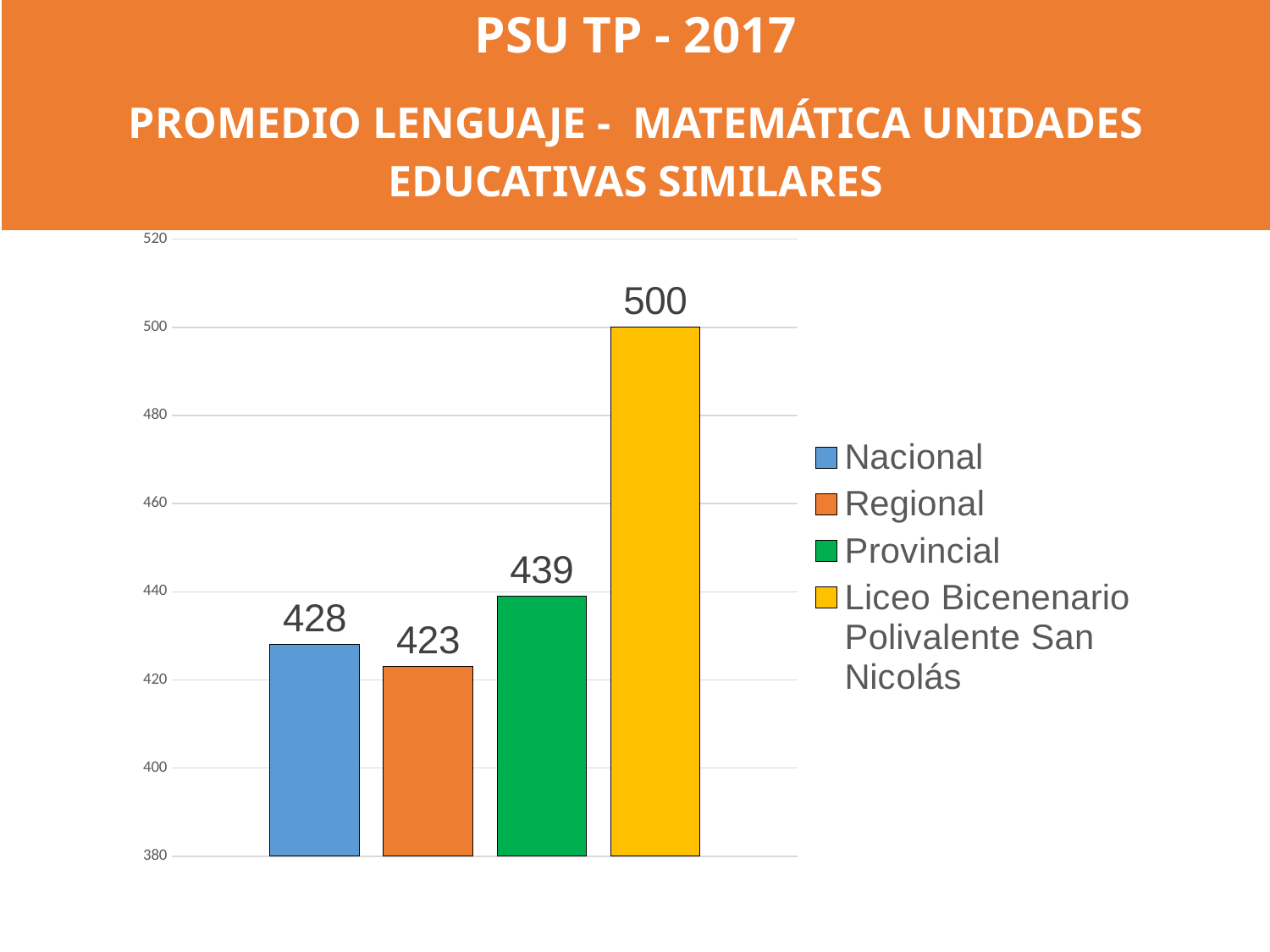
What kind of chart is shown on the slide? Bar chart How many series does the legend list? 4 What is the value for Regional? 423 What is the value for Provincial? 439 What is the value for Nacional? 428 What is the difference between the Liceo Bicenenario Polivalente San Nicolás value and the Nacional value? 72 What is the value for Liceo Bicenenario Polivalente San Nicolás? 500 What colour is the bar for Provincial? Green What is the difference between the Provincial value and the Regional value? 16 Which series has the highest value? Liceo Bicenenario Polivalente San Nicolás Which is larger, the Nacional value or the Provincial value? Provincial Which series has the lowest value? Regional